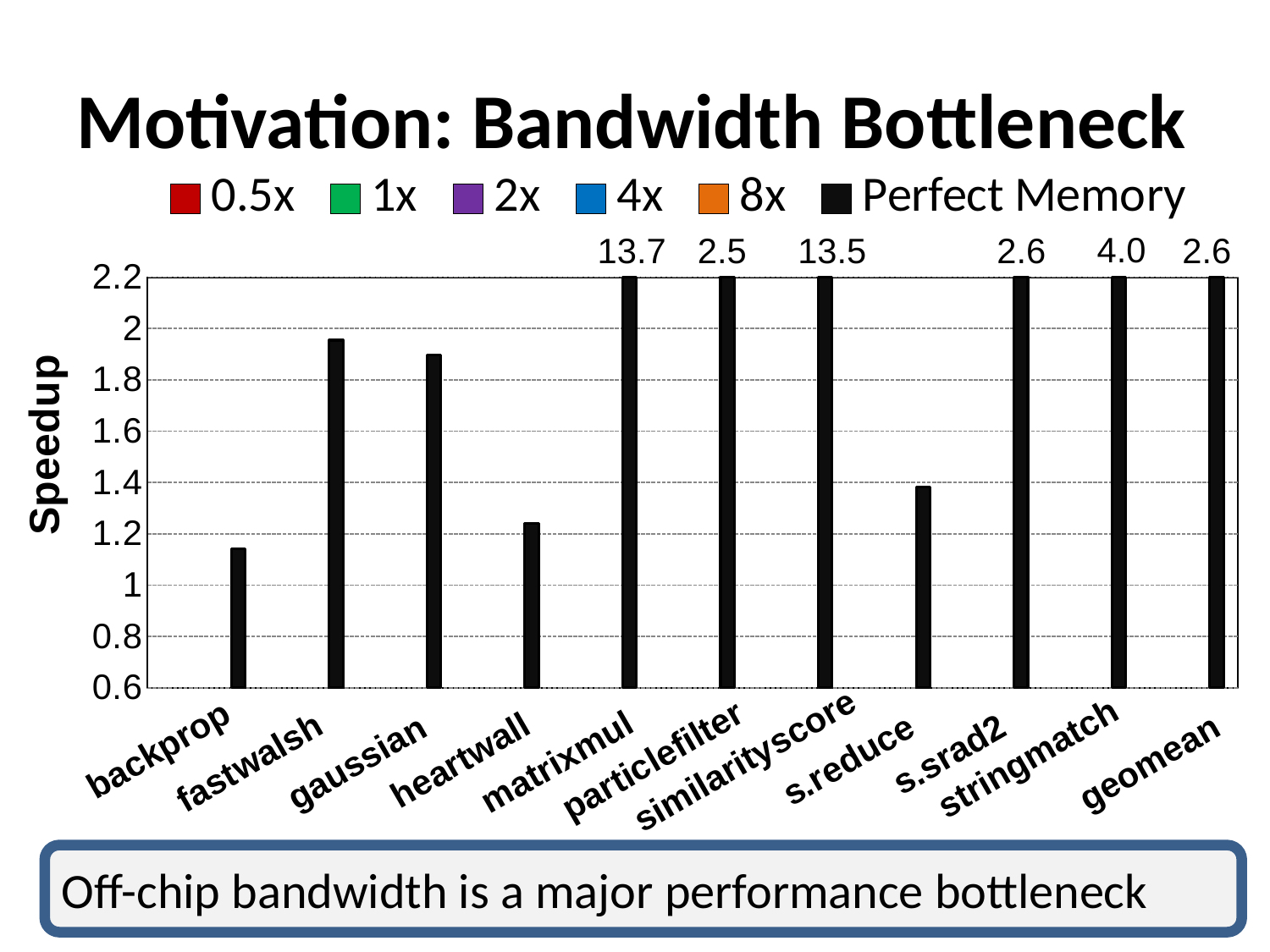
How many series does the legend list? 6 Is the speedup for backprop greater or less than 1.2? less What is the difference between the speedups of matrixmul and similarityscore? 0.2 What is the Perfect Memory speedup for matrixmul? 13.7 What is the label of the y axis? Speedup Which benchmark has the highest speedup? matrixmul What kind of chart is shown on the slide? bar chart Is the speedup for fastwalsh greater or less than 1.8? greater What is the geomean speedup shown on the chart? 2.6 What is the Perfect Memory speedup for stringmatch? 4.0 Which has a larger speedup, particlefilter or s.srad2? s.srad2 How many benchmarks (categories) are shown on the x axis? 11